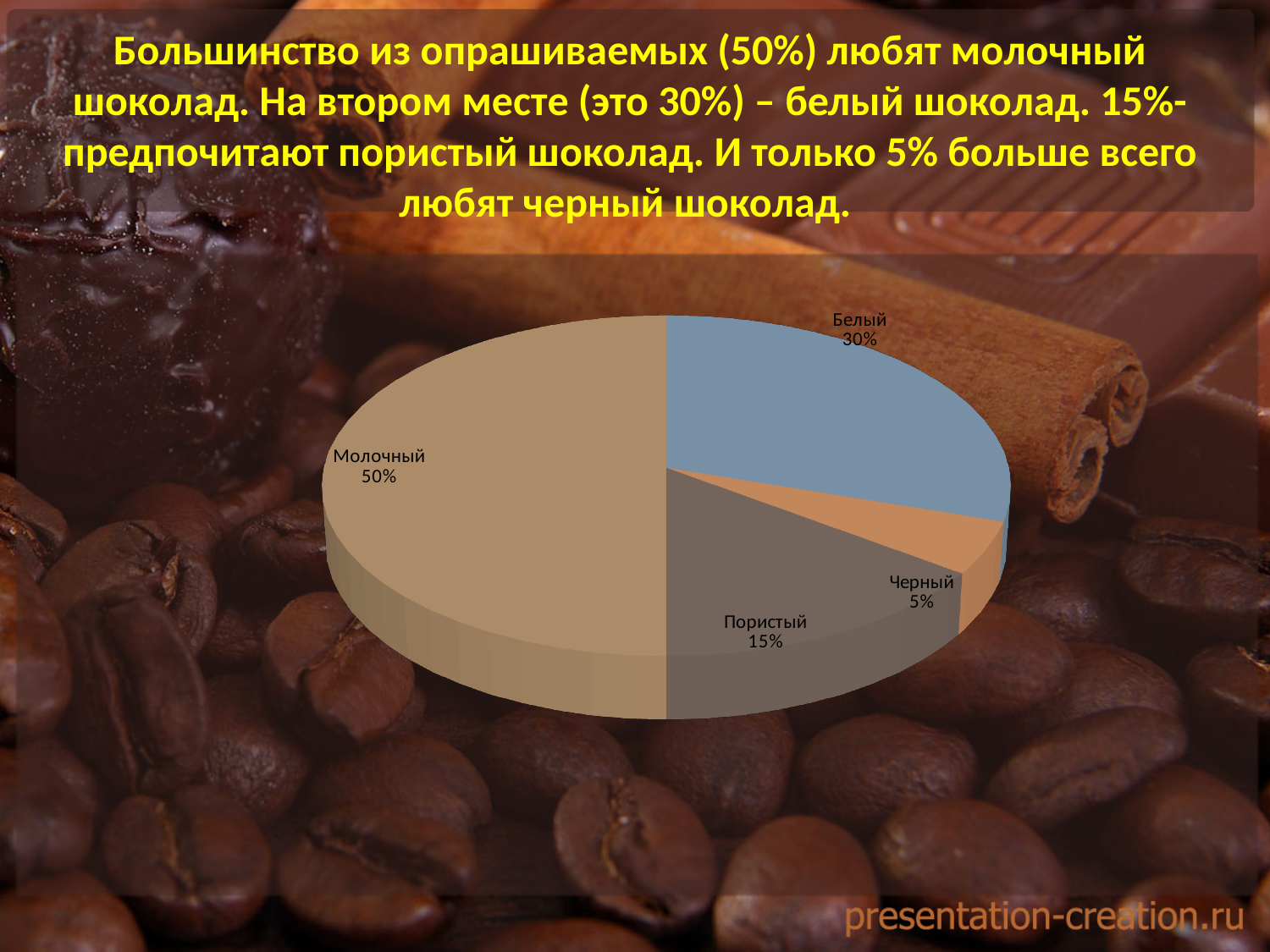
What share of the pie does Молочный have? 50% What colour is the slice for Белый? blue What share of the pie does Черный have? 5% What share of the pie does Пористый have? 15% What is the difference in percentage points between Молочный and Белый? 20 Which category has the smallest slice of the pie? Черный Which is larger, the slice for Белый or the slice for Пористый? Белый What is the difference in percentage points between Пористый and Черный? 10 What share of the pie does Белый have? 30% Which category has the largest slice of the pie? Молочный How many slices does the pie chart have? 4 What kind of chart is shown on the slide? pie chart